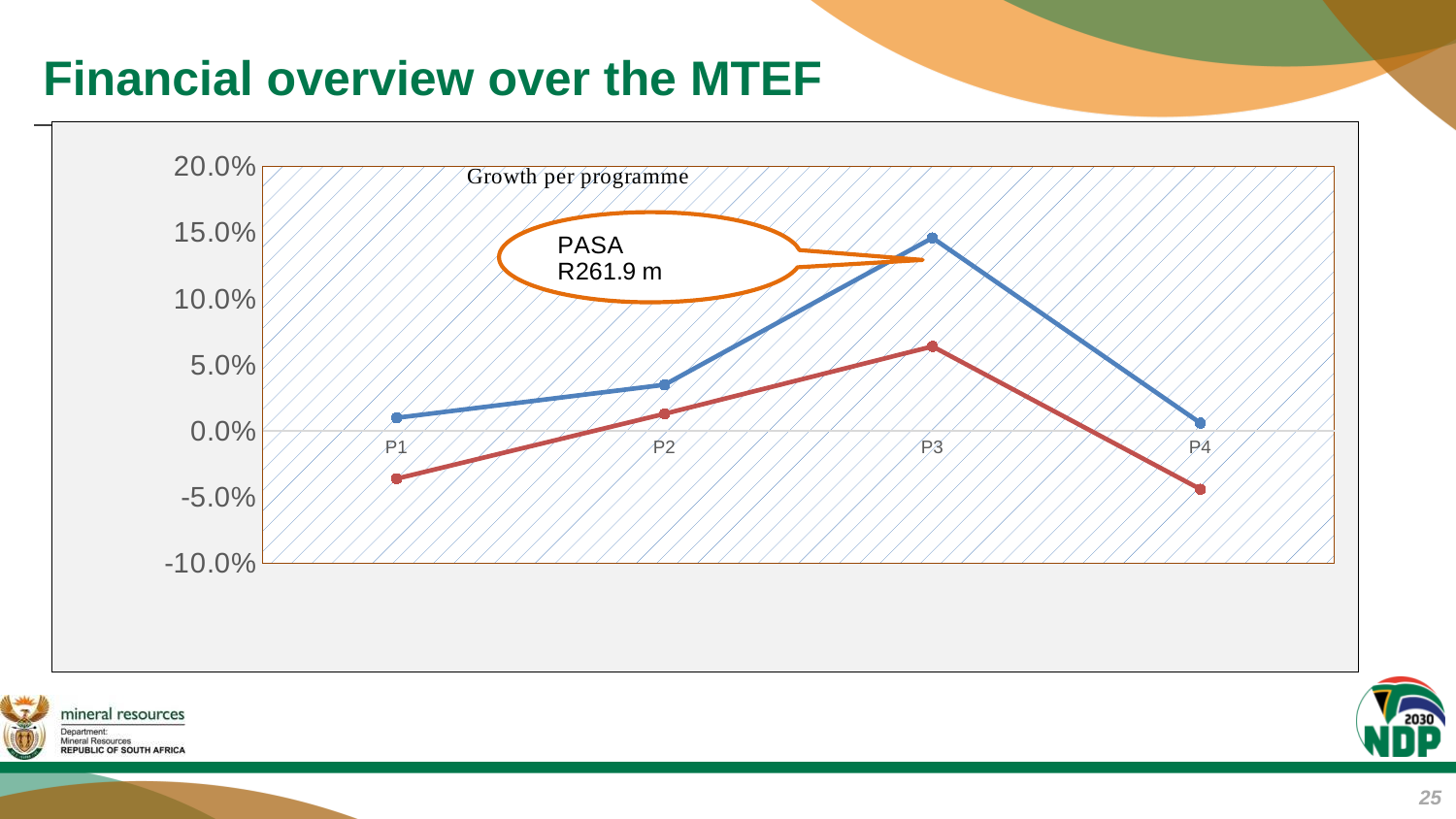
Do the values of both lines rise or fall from P3 to P4? fall What text appears in the callout pointing at the P3 point of the blue line? PASA R261.9 m Is the blue line's value for P3 greater or less than 10.0%? greater What kind of chart is shown on the slide? line chart How many programme categories are shown on the x axis? 4 Is the blue line's value for P2 greater or less than 5.0%? less Is the red line's value for P1 greater or less than 0.0%? less At P3, which line has the larger value, the blue line or the red line? the blue line For the blue line, which programme has the highest value? P3 For the red line, which programme has the highest value? P3 How many lines are plotted on the chart? 2 What is the title of the chart? Growth per programme